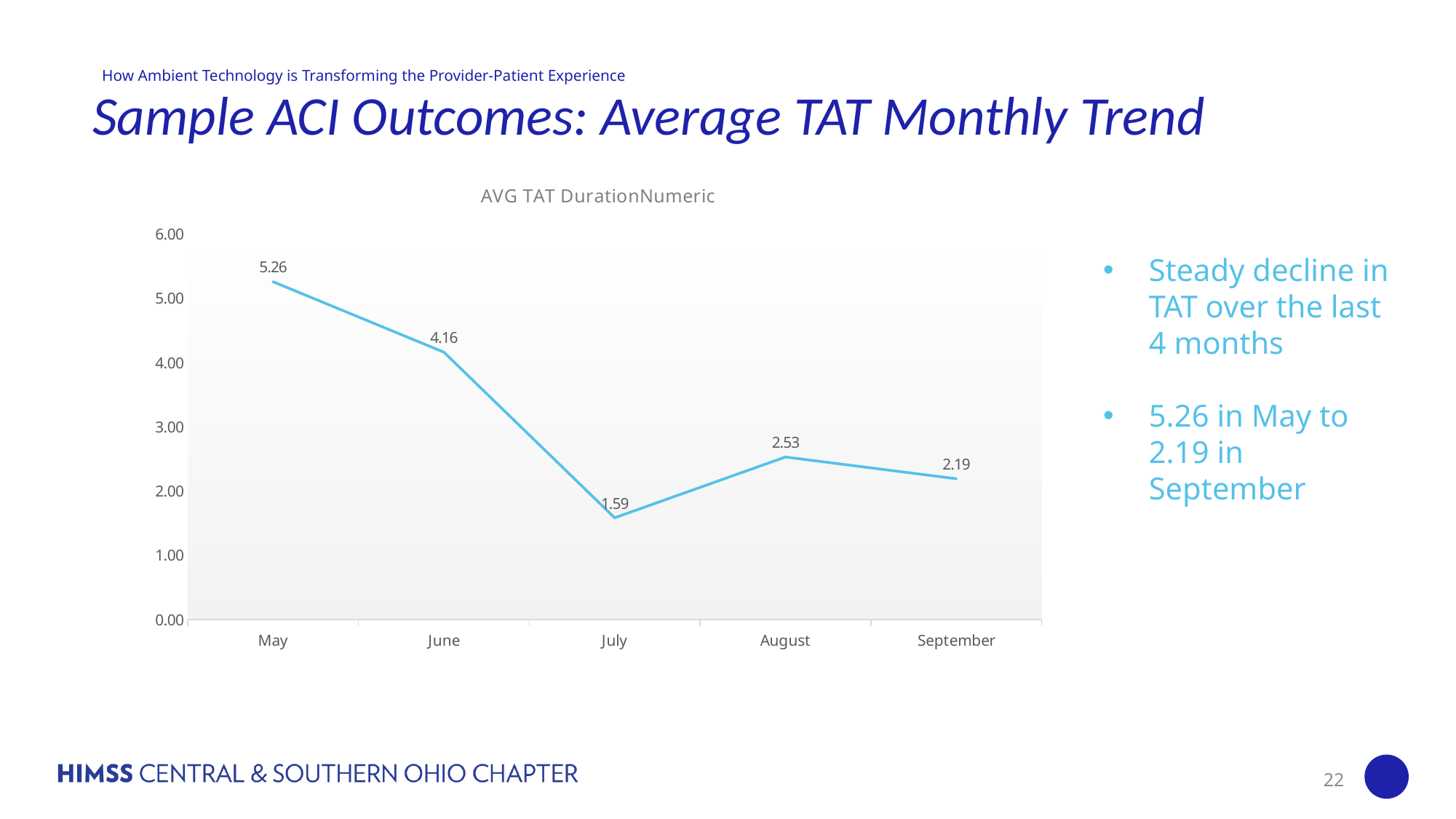
What kind of chart is shown on the slide? Line chart What is the difference between the June value and the July value? 2.57 What is the AVG TAT DurationNumeric value for May? 5.26 What is the AVG TAT DurationNumeric value for July? 1.59 What is the AVG TAT DurationNumeric value for September? 2.19 What is the difference between the May value and the September value? 3.07 Which month has the highest AVG TAT DurationNumeric value? May What is the title of the chart? AVG TAT DurationNumeric Which month has a larger value, August or September? August Is the value for June greater or less than 4.00? greater Which month has the lowest AVG TAT DurationNumeric value? July How many months are plotted on the chart? 5